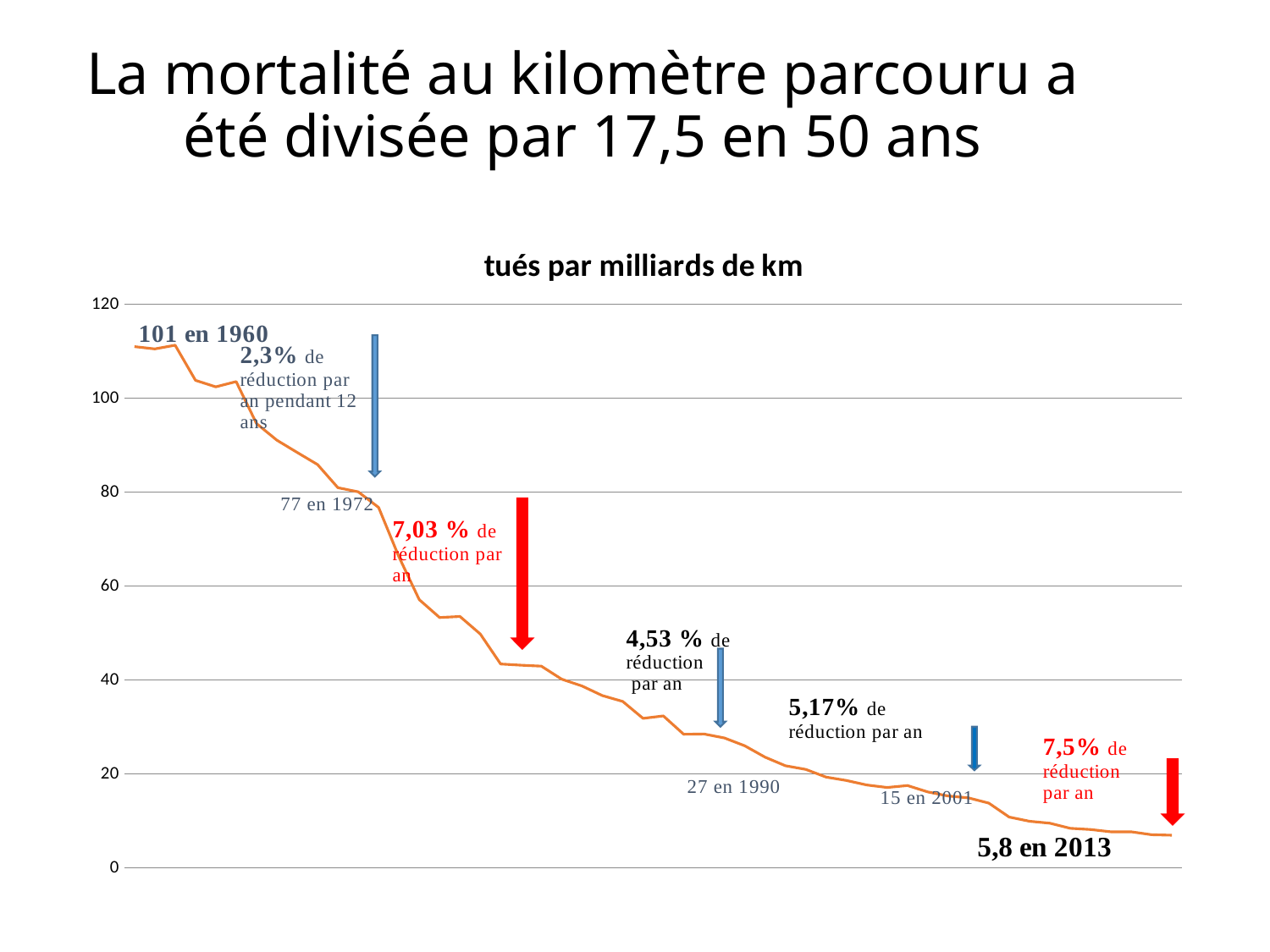
What value is annotated for 2001? 15 Which annotated year has the higher value, 1972 or 1990? 1972 What value is annotated for 2013? 5,8 What value is annotated for 1960? 101 What is the difference between the annotated values for 1960 and 1972? 24 What value is annotated for 1990? 27 What is the chart's title? tués par milliards de km Do the values rise or fall along the x axis? fall What kind of chart is shown on the slide? line chart What annual reduction rate is annotated for the 12 years after 1960? 2,3% What value is annotated for 1972? 77 What is the difference between the annotated values for 1990 and 2001? 12